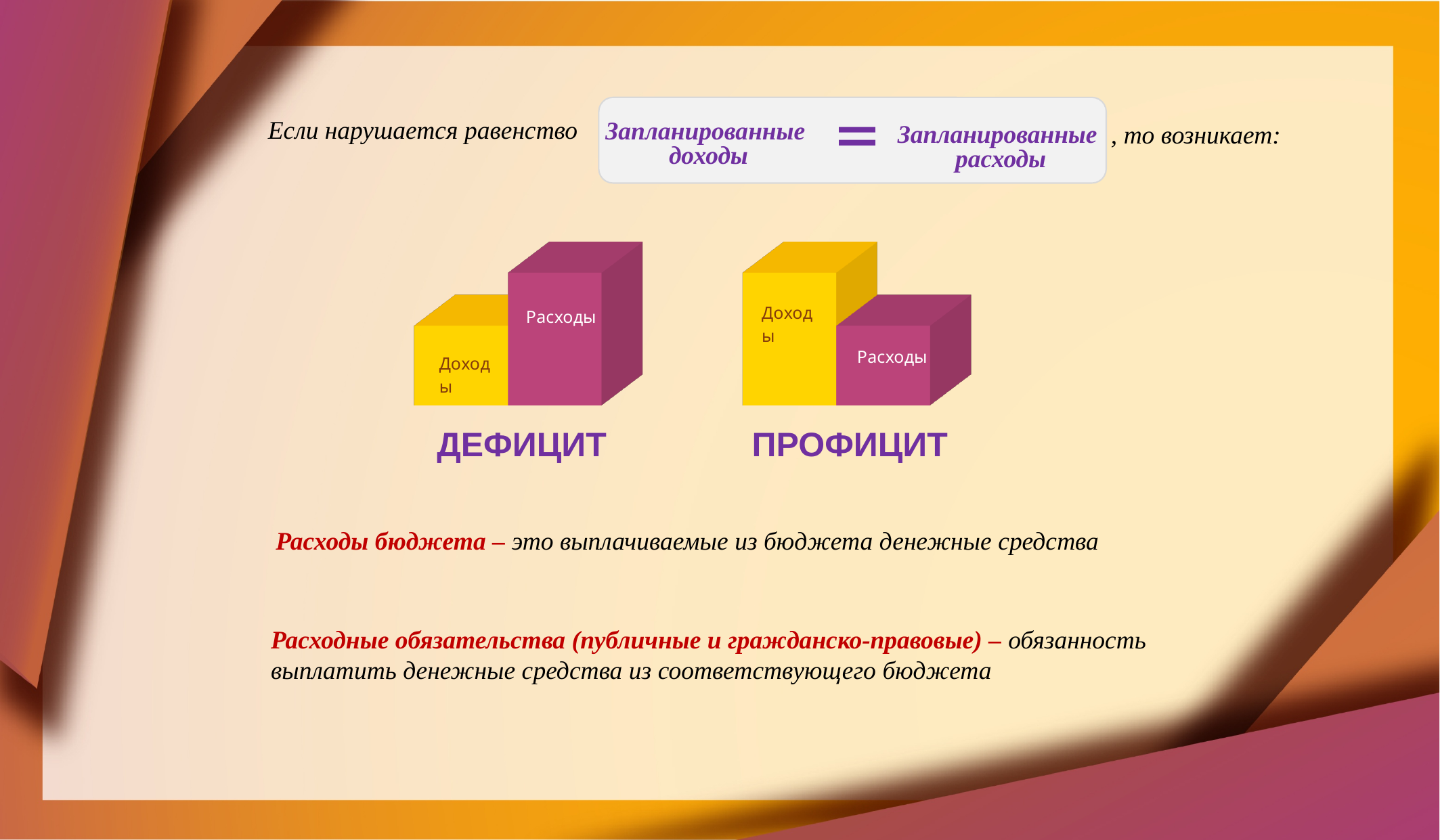
In the ДЕФИЦИТ chart, what colour is the Доходы bar? yellow In the ДЕФИЦИТ chart, how many bars are there? 2 In the ПРОФИЦИТ chart, which category has the lowest bar? Расходы In the ПРОФИЦИТ chart, what colour is the Расходы bar? magenta In the ПРОФИЦИТ chart, how many bars are there? 2 In the ДЕФИЦИТ chart, which bar is taller, Доходы or Расходы? Расходы In the ДЕФИЦИТ chart, which category has the lowest bar? Доходы What kind of chart is shown under the label ПРОФИЦИТ? bar chart What kind of chart is shown under the label ДЕФИЦИТ? bar chart In the ПРОФИЦИТ chart, which bar is taller, Доходы or Расходы? Доходы In the ДЕФИЦИТ chart, which category has the highest bar? Расходы In the ПРОФИЦИТ chart, which category has the highest bar? Доходы